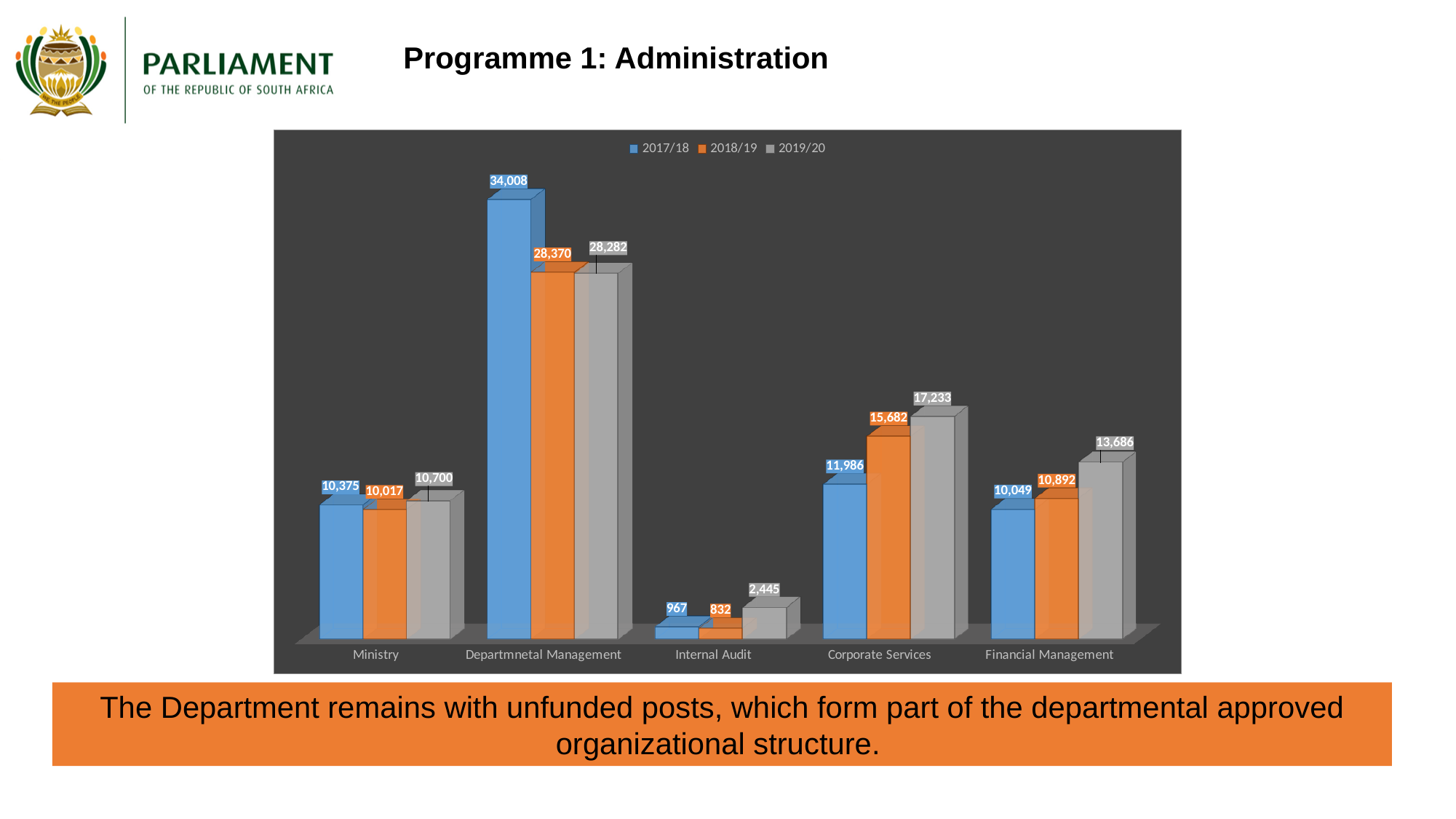
How many series does the legend list? 3 What is the difference between the 2017/18 and 2018/19 values for Departmnetal Management? 5,638 How many categories are shown on the x axis? 5 What is the 2019/20 value for Internal Audit? 2,445 What kind of chart is shown on the slide? Bar chart What is the 2018/19 value for Corporate Services? 15,682 What is the 2019/20 value for Financial Management? 13,686 Which category has the highest 2019/20 value? Departmnetal Management What is the 2017/18 value for Departmnetal Management? 34,008 Which category has the lowest 2018/19 value? Internal Audit Which is larger for Ministry: the 2017/18 value or the 2019/20 value? 2019/20 Do the values for Corporate Services rise or fall from 2017/18 to 2019/20? Rise